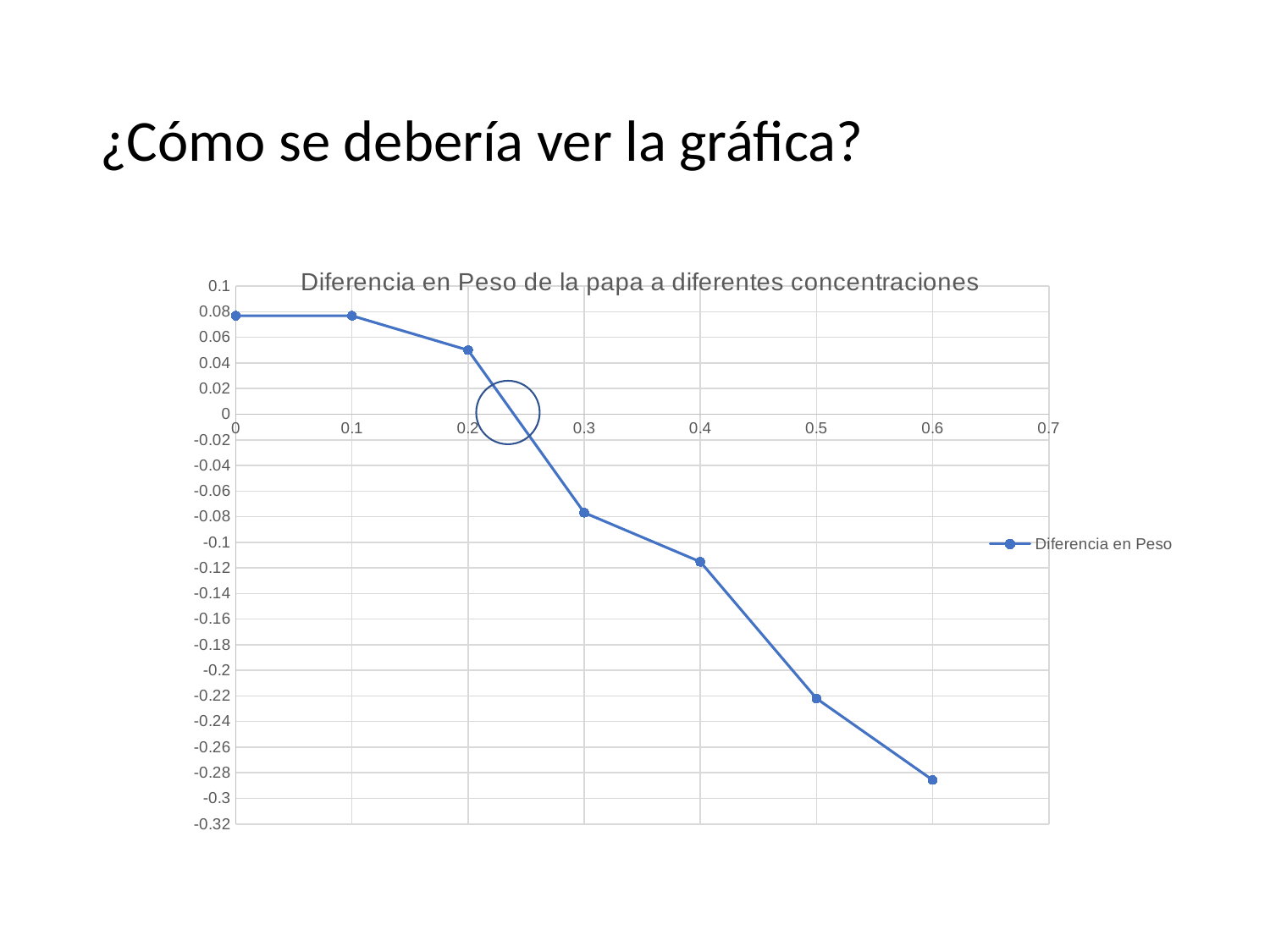
What kind of chart is shown on the slide? line chart At which concentration on the x axis is the Diferencia en Peso lowest? 0.6 Do the values rise or fall as the concentration increases along the x axis? fall Is the value for concentration 0.4 greater or less than -0.1? less Which has the larger Diferencia en Peso, concentration 0.3 or concentration 0.5? 0.3 How many series does the legend list? 1 Is the value for concentration 0 greater or less than 0.06? greater What is the name of the series shown in the legend? Diferencia en Peso Is the value for concentration 0.3 greater or less than 0? less What is the title of the chart? Diferencia en Peso de la papa a diferentes concentraciones How many data points are plotted on the line? 7